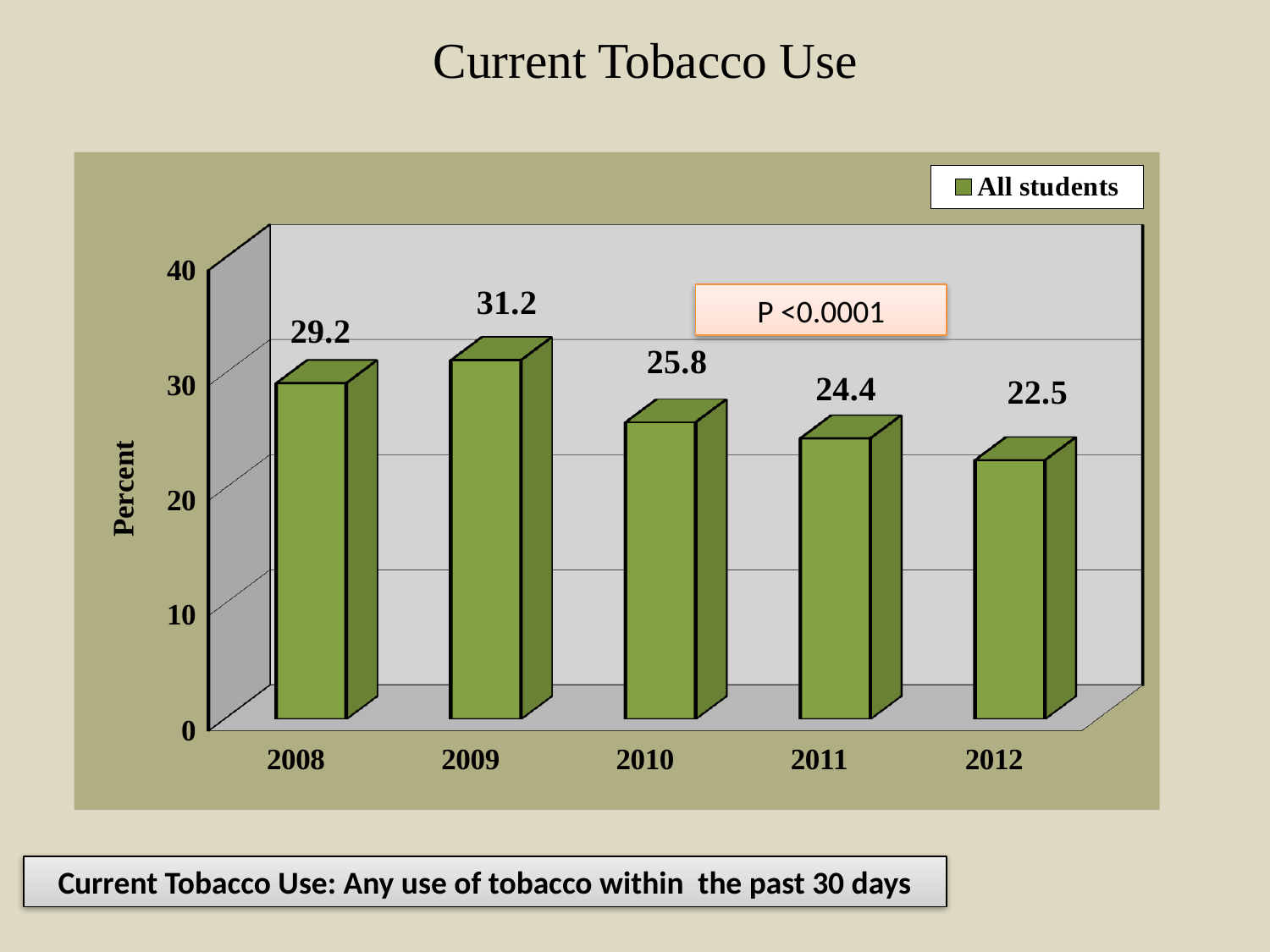
Which is larger, the value for 2008 or the value for 2011? 2008 How many series does the legend list? 1 What is the difference between the values for 2009 and 2012? 8.7 Is the value for 2011 greater or less than 30? less What kind of chart is shown? bar chart What is the value for 2008? 29.2 Do the values rise or fall from 2009 to 2012? fall What is the value for 2010? 25.8 Which year has the lowest value? 2012 What is the value for 2012? 22.5 Which year has the highest value? 2009 How many years are shown on the x axis? 5